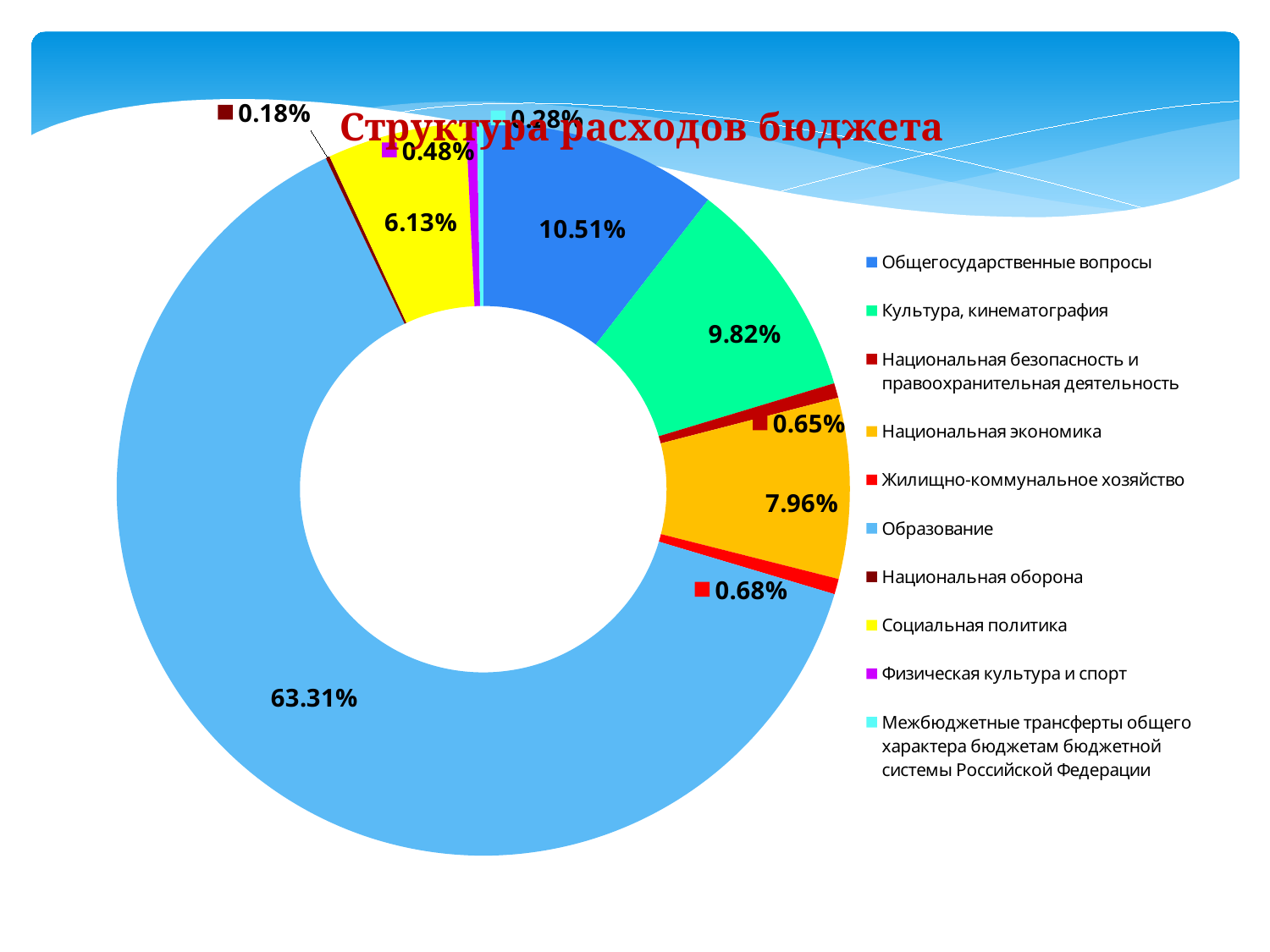
Which is larger: the share for Национальная экономика or the share for Социальная политика? Национальная экономика How many categories does the legend list? 10 What percentage is shown for Социальная политика? 6.13% What type of chart is shown on the slide? Doughnut (pie) chart What is the value for Культура, кинематография? 9.82% Which category has the smallest share of budget expenditure? Национальная оборона What share of the budget expenditure goes to Образование? 63.31% Which category has the largest share of budget expenditure? Образование What is the difference between the shares for Общегосударственные вопросы and Культура, кинематография? 0.69% What share is labelled for Национальная экономика? 7.96% What percentage is shown for Общегосударственные вопросы? 10.51% What is the value for Жилищно-коммунальное хозяйство? 0.68%